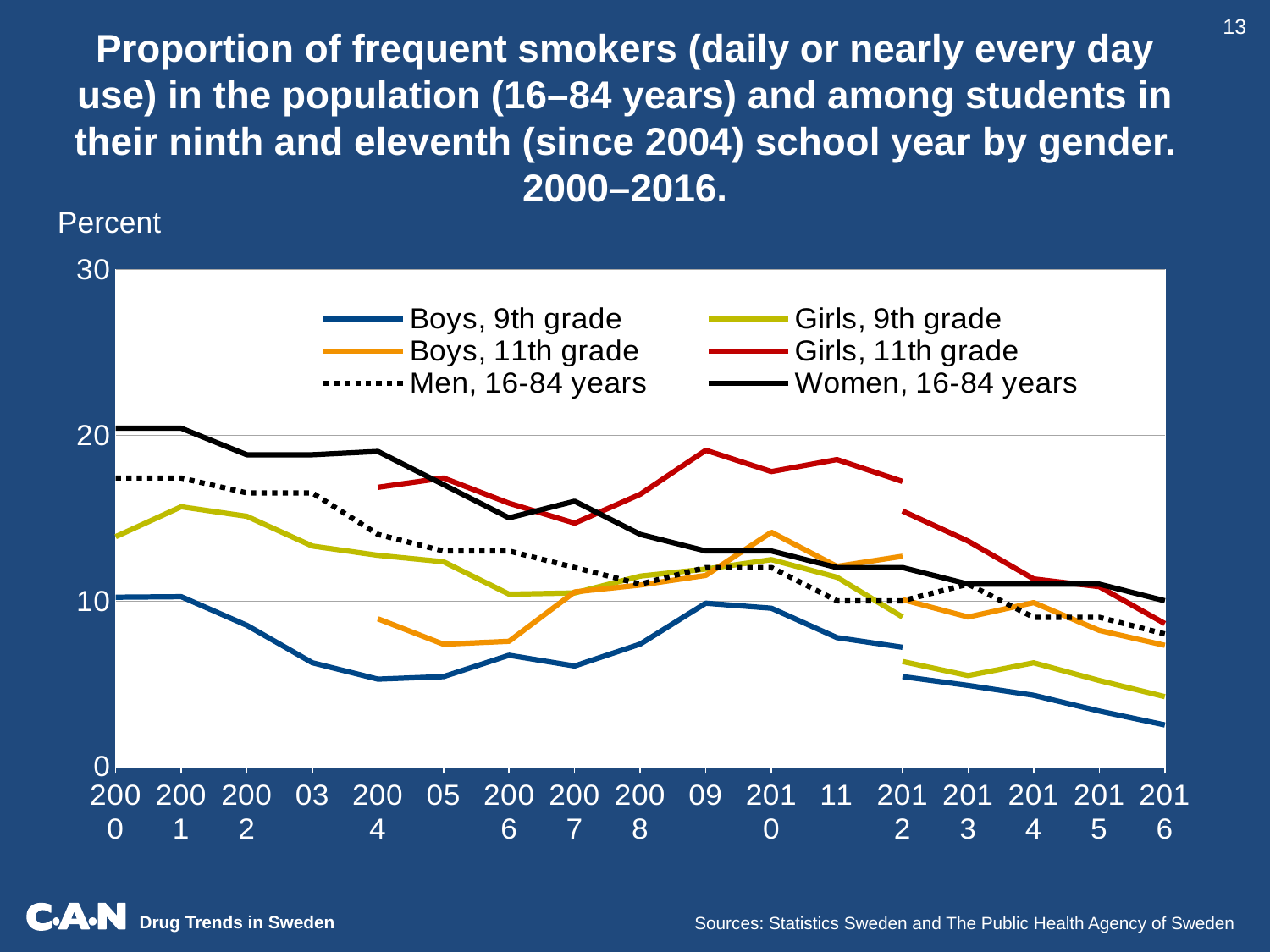
Is the value for Men, 16-84 years in 2000 greater or less than 10? greater Is the value for Boys, 9th grade in 2016 greater or less than 10? less Which series has the highest value in 2009? Girls, 11th grade What kind of chart is shown on the slide? line chart Does the Women, 16-84 years line rise or fall overall from 2000 to 2016? fall How many series does the legend list? 6 In 2010, which is larger: Girls, 11th grade or Boys, 9th grade? Girls, 11th grade How many years are shown along the x axis? 17 Which series has the lowest value in 2016? Boys, 9th grade Is the value for Boys, 11th grade in 2005 greater or less than 10? less What unit label is shown above the y axis? Percent